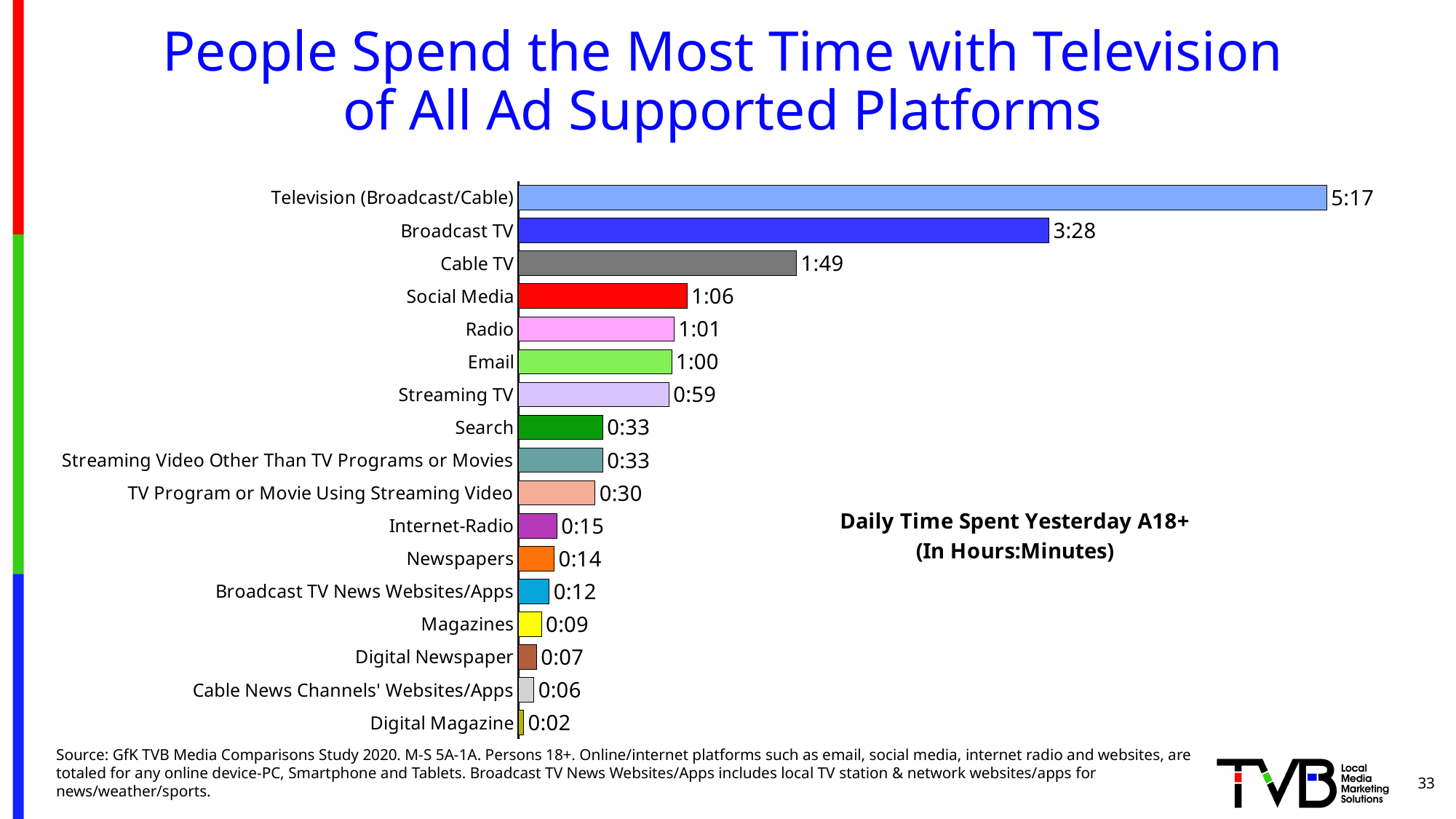
What kind of chart is shown on the slide? Bar chart In what units are the values in the chart expressed? Hours:Minutes What is the difference in daily time spent between Broadcast TV and Cable TV? 1:39 How many platforms are shown in the chart? 17 What is the difference in daily time spent between Social Media and Radio? 0:05 What is the daily time spent with Broadcast TV? 3:28 Which platform has the lowest daily time spent? Digital Magazine Which has a higher daily time spent, Newspapers or Magazines? Newspapers Which platform has the highest daily time spent? Television (Broadcast/Cable) What is the daily time spent with Streaming TV? 0:59 What is the daily time spent with Digital Newspaper? 0:07 What is the daily time spent with Television (Broadcast/Cable)? 5:17